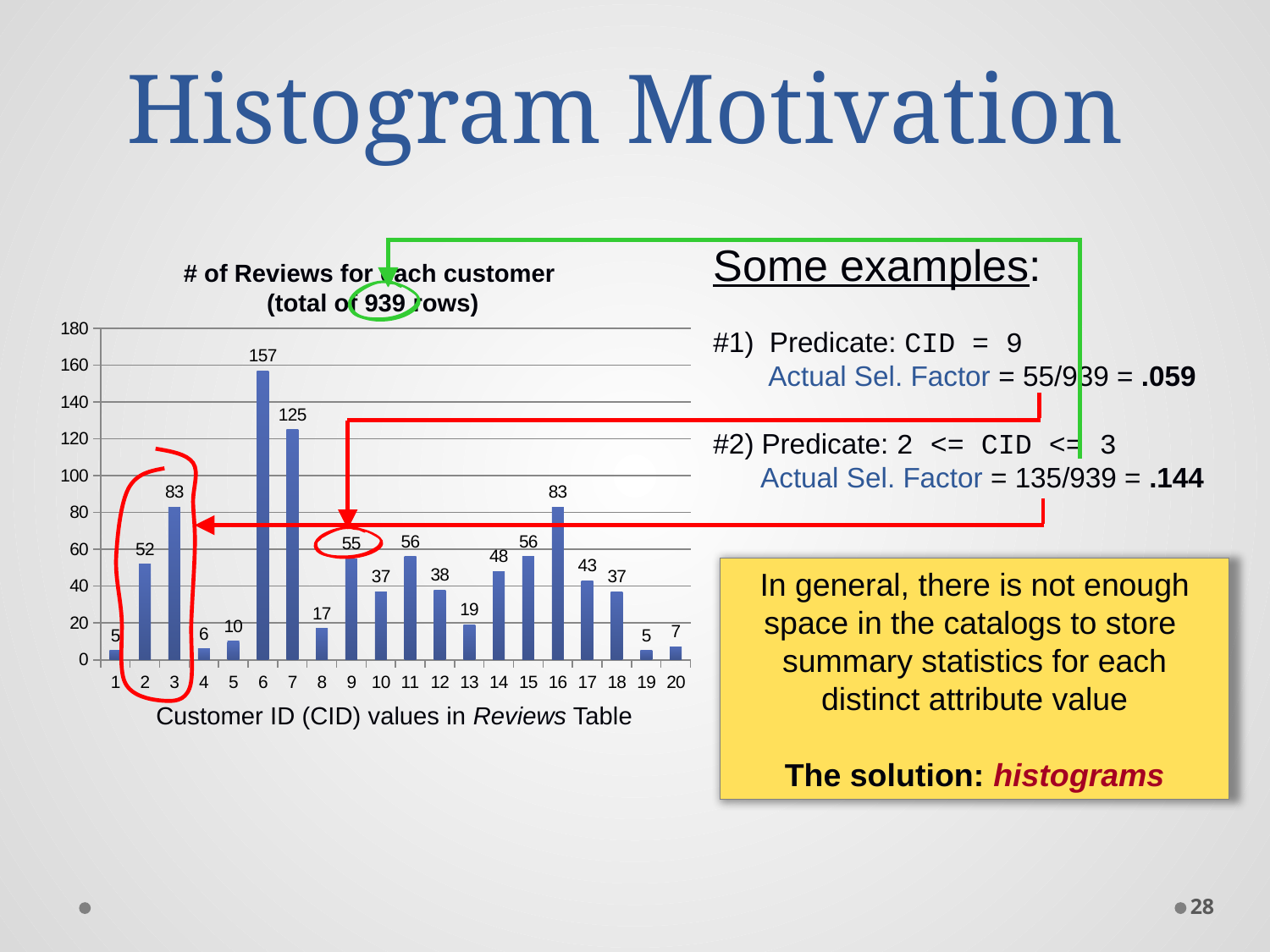
Which has more reviews, customer ID 10 or customer ID 13? Customer ID 10 What is the difference in number of reviews between customer ID 6 and customer ID 7? 32 What is the label of the x axis of the chart? Customer ID (CID) values in Reviews Table What kind of chart is shown on the slide? Bar chart What is the number of reviews for customer ID 9? 55 Is the number of reviews for customer ID 16 greater or less than 60? greater What is the difference in number of reviews between customer ID 3 and customer ID 2? 31 What is the number of reviews for customer ID 20? 7 What is the title of the chart? # of Reviews for each customer (total of 939 rows) What is the number of reviews for customer ID 7? 125 Which customer ID has the highest number of reviews? 6 How many customer IDs are shown on the x axis of the chart? 20